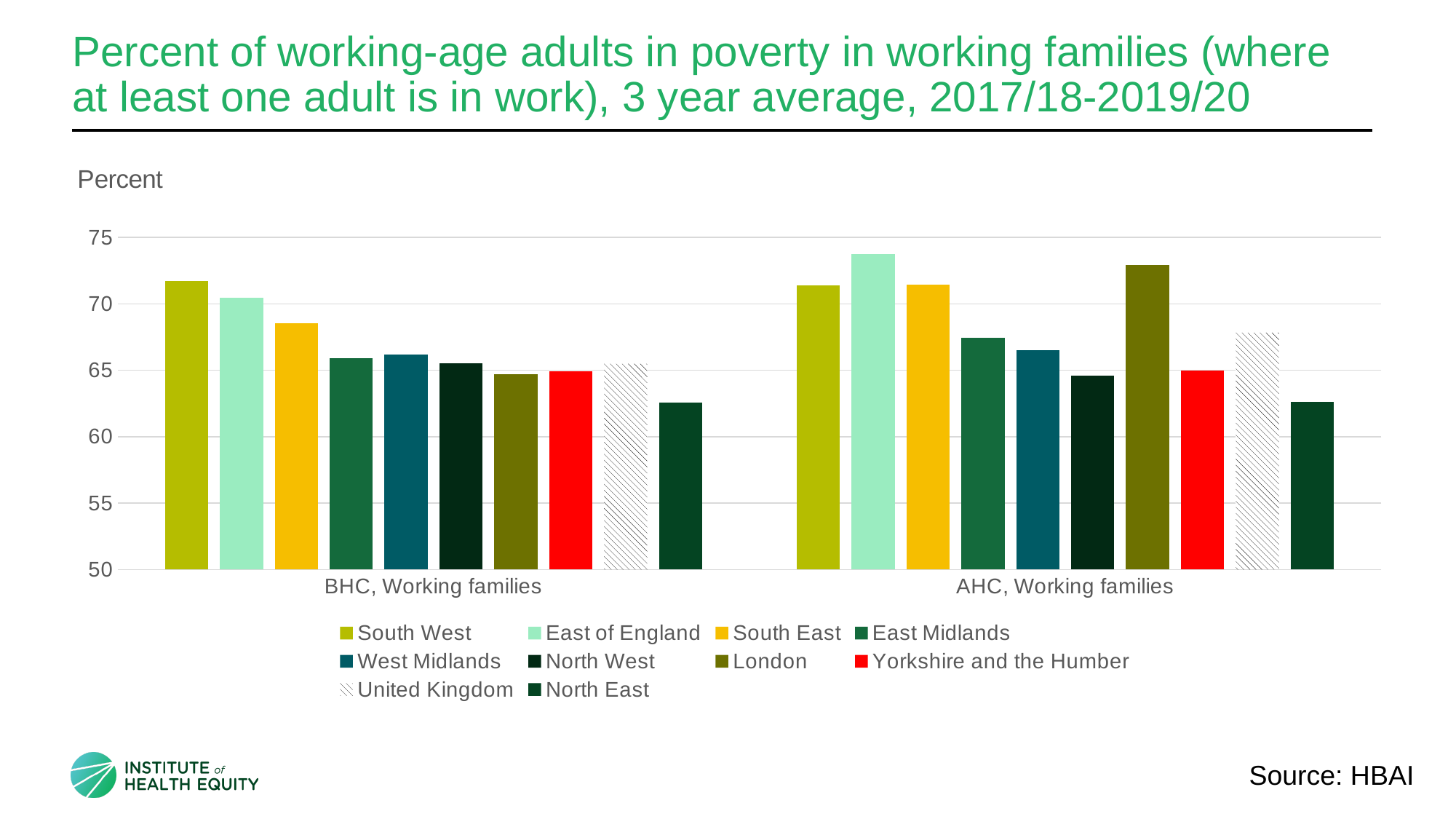
Is the value for South East in the BHC, Working families group greater or less than 70? less How many categories are shown on the x axis? 2 In the AHC, Working families group, which is larger: London or Yorkshire and the Humber? London What kind of chart is shown on the slide? bar chart How many series does the legend list? 10 Is the value for South West in the BHC, Working families group greater or less than 70? greater Is the value for North East in the BHC, Working families group greater or less than 65? less Which region has the lowest value in the BHC, Working families group? North East Which region has the highest value in the BHC, Working families group? South West Which region has the lowest value in the AHC, Working families group? North East Which series is drawn with a hatched pattern in the legend? United Kingdom